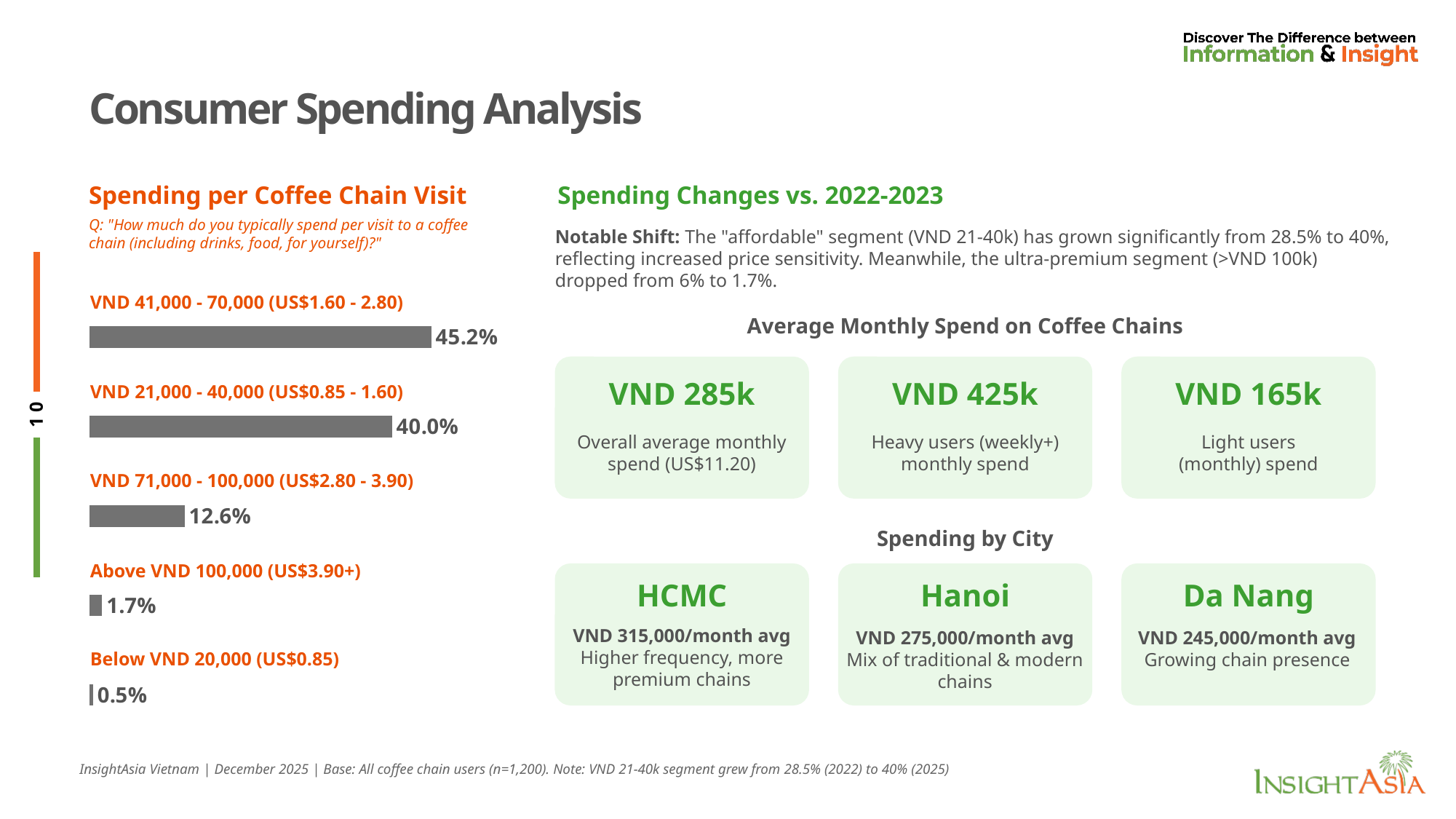
In the 'Spending per Coffee Chain Visit' chart, what percentage of respondents spend VND 41,000 - 70,000 per visit? 45.2% In the 'Spending per Coffee Chain Visit' chart, what percentage spend Above VND 100,000 per visit? 1.7% In the 'Spending per Coffee Chain Visit' chart, what is the value for Below VND 20,000? 0.5% In the 'Spending per Coffee Chain Visit' chart, which is larger: the share for VND 71,000 - 100,000 or the share for Above VND 100,000? VND 71,000 - 100,000 In the 'Spending per Coffee Chain Visit' chart, which spending band has the lowest share? Below VND 20,000 (US$0.85) In the 'Spending per Coffee Chain Visit' chart, what is the value for VND 21,000 - 40,000? 40.0% In the 'Spending per Coffee Chain Visit' chart, what is the value for VND 71,000 - 100,000? 12.6% How many spending bands are shown in the 'Spending per Coffee Chain Visit' chart? 5 In the 'Spending per Coffee Chain Visit' chart, what is the difference between the VND 41,000 - 70,000 share and the VND 21,000 - 40,000 share? 5.2% What type of chart is 'Spending per Coffee Chain Visit'? Bar chart In the 'Spending per Coffee Chain Visit' chart, which spending band has the highest share? VND 41,000 - 70,000 (US$1.60 - 2.80) What is the title of the chart on the left side of the slide? Spending per Coffee Chain Visit